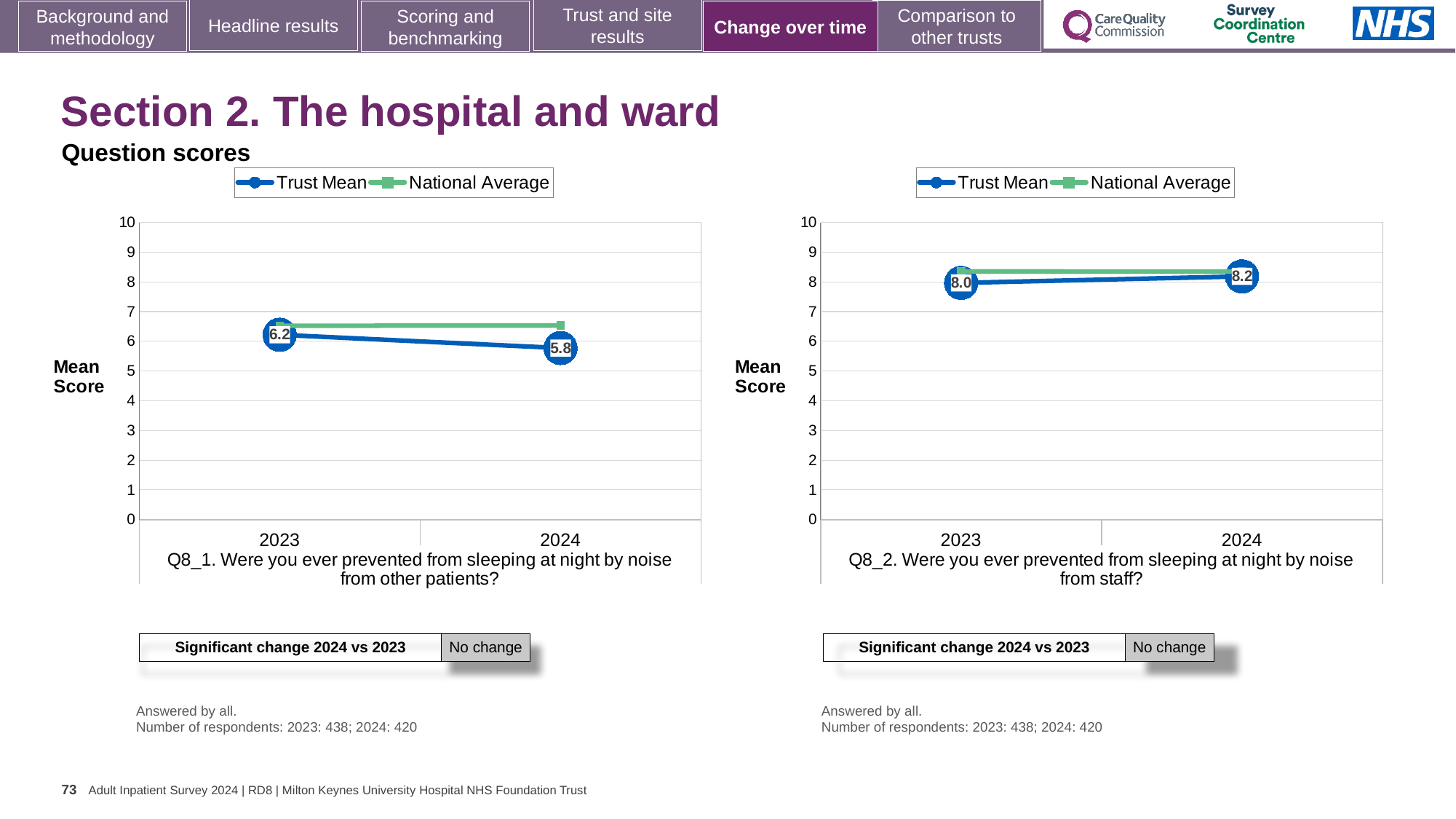
In the right chart (Q8_2), what is the difference between the Trust Mean for 2024 and 2023? 0.2 In the left chart (Q8_1), does the Trust Mean rise or fall from 2023 to 2024? fall In the left chart (Q8_1), what is the Trust Mean score for 2023? 6.2 In the left chart (Q8_1), by how much did the Trust Mean change from 2023 to 2024? 0.4 What kind of chart is the left chart (Q8_1)? line chart In the right chart (Q8_2), what is the Trust Mean score for 2024? 8.2 In the left chart (Q8_1), is the National Average value for 2024 greater or less than 6? greater How many series does the legend of the right chart (Q8_2) list? 2 In the right chart (Q8_2), what is the Trust Mean score for 2023? 8.0 In the right chart (Q8_2), which year has the higher Trust Mean, 2023 or 2024? 2024 In the right chart (Q8_2), does the Trust Mean rise or fall from 2023 to 2024? rise In the left chart (Q8_1), what is the Trust Mean score for 2024? 5.8